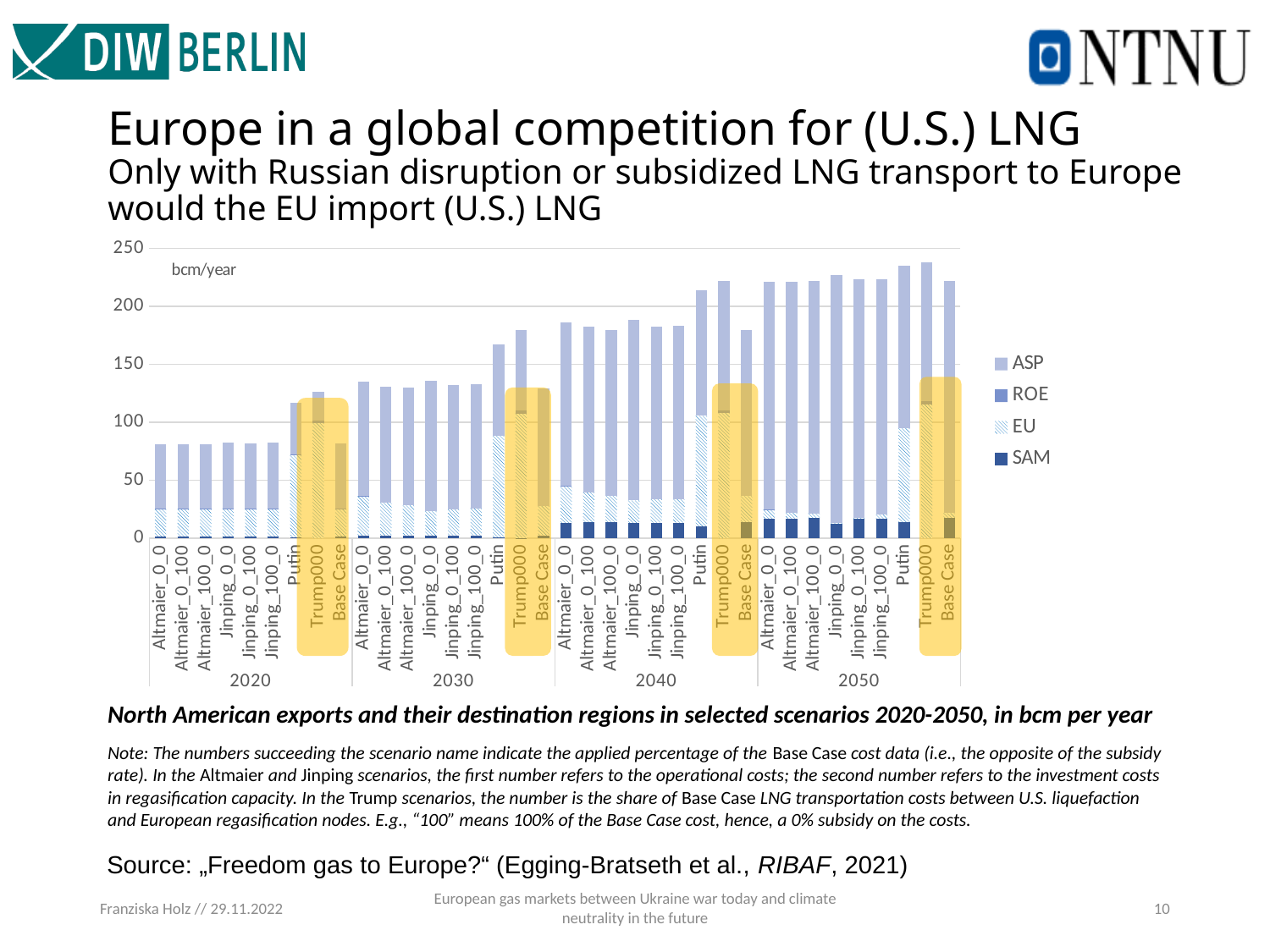
Which year group contains the tallest bars? 2050 How many year groups are shown along the x axis? 4 How many series does the legend list? 4 What kind of chart is shown on the slide? stacked bar chart How many scenario bars are shown within each year group? 9 Is the total value for Trump000 in 2050 greater or less than 200? greater Is the total value for Altmaier_0_0 in 2040 greater or less than 200? less Which series are listed in the legend? ASP, ROE, EU, SAM Is the total value for Putin in 2030 greater or less than 150? greater What unit is shown on the chart for the values? bcm/year Which year group contains the shortest bars? 2020